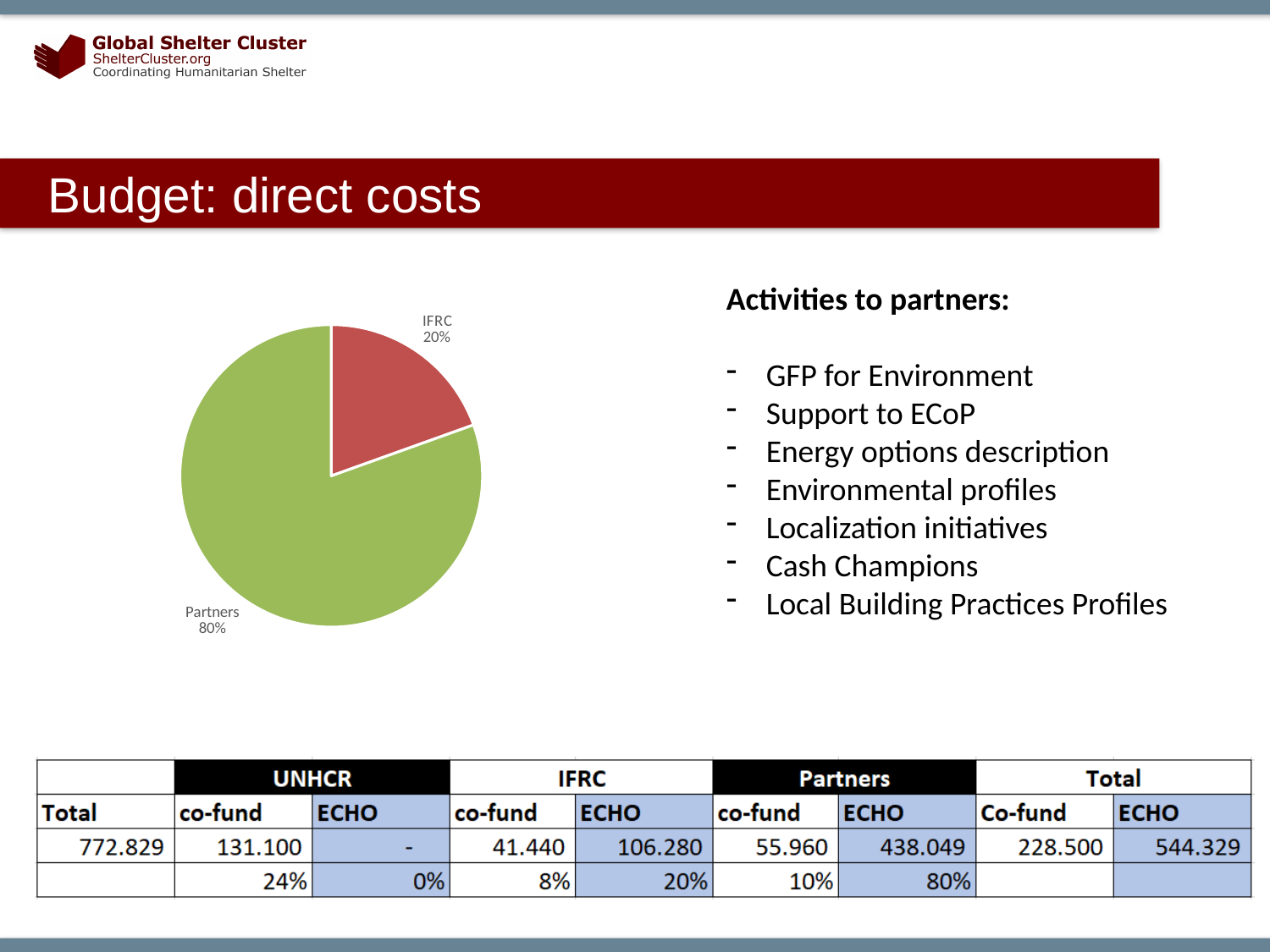
How many slices does the pie chart have? 2 What share of the pie does Partners have? 80% What colour is the Partners slice of the pie? green What is the difference in percentage points between the Partners slice and the IFRC slice? 60% What share of the pie does IFRC have? 20% Which is larger in the pie chart, IFRC or Partners? Partners Which slice of the pie is the largest? Partners What kind of chart is shown on the slide? pie chart Which slice of the pie is the smallest? IFRC What colour is the IFRC slice of the pie? red